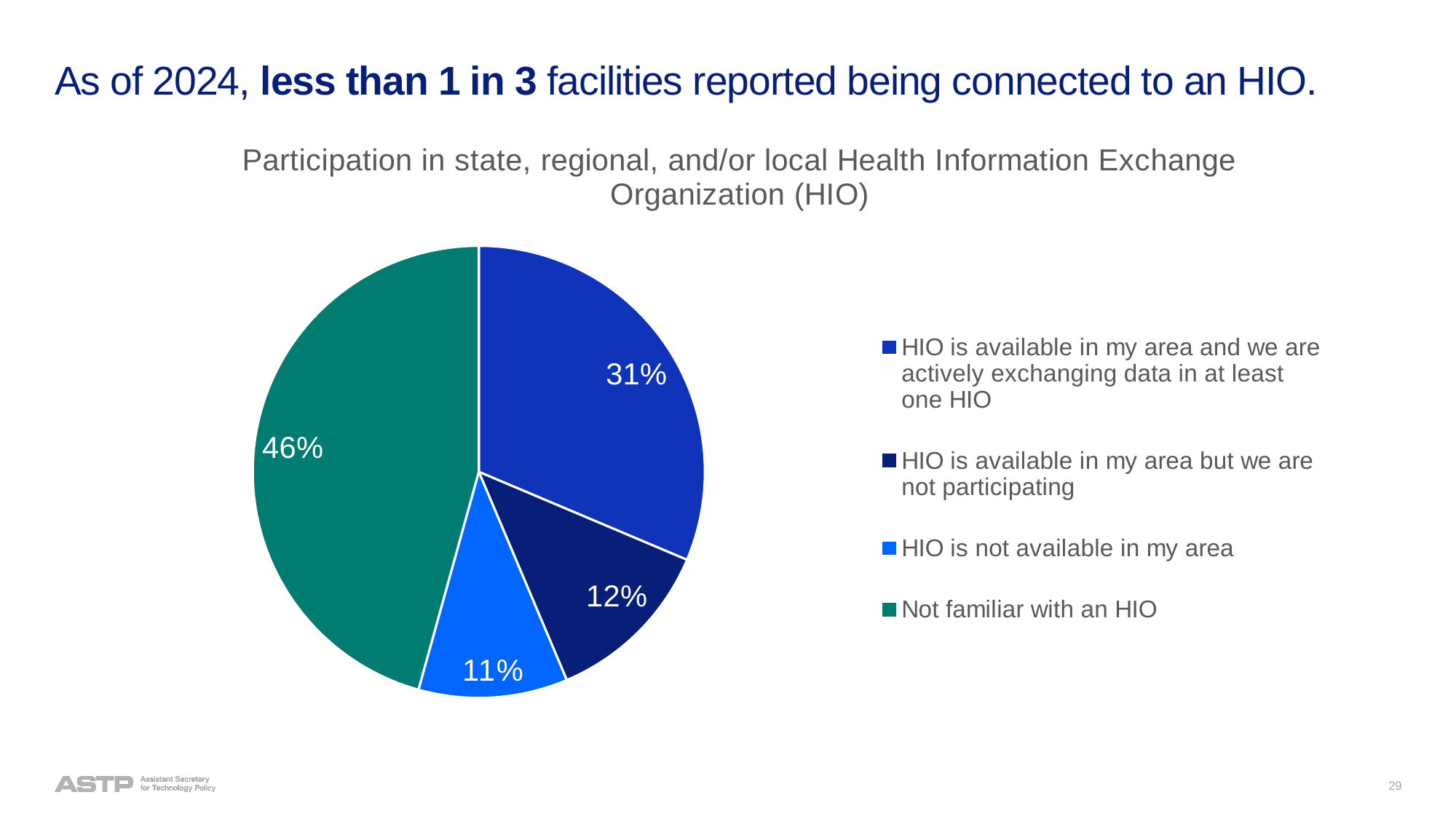
What share of facilities reported 'Not familiar with an HIO'? 46% How many categories does the pie chart show? 4 Which category has the smallest slice of the pie? HIO is not available in my area Which category has the largest slice of the pie? Not familiar with an HIO What is the title of the pie chart? Participation in state, regional, and/or local Health Information Exchange Organization (HIO) What colour is the slice for 'Not familiar with an HIO'? Teal green What kind of chart is shown on the slide? Pie chart What share of facilities reported 'HIO is available in my area but we are not participating'? 12% What share of facilities reported 'HIO is not available in my area'? 11% What is the difference in percentage points between 'Not familiar with an HIO' and 'HIO is available in my area and we are actively exchanging data in at least one HIO'? 15 percentage points What share of facilities reported 'HIO is available in my area and we are actively exchanging data in at least one HIO'? 31% Which is larger: the share for 'HIO is available in my area but we are not participating' or the share for 'HIO is not available in my area'? HIO is available in my area but we are not participating